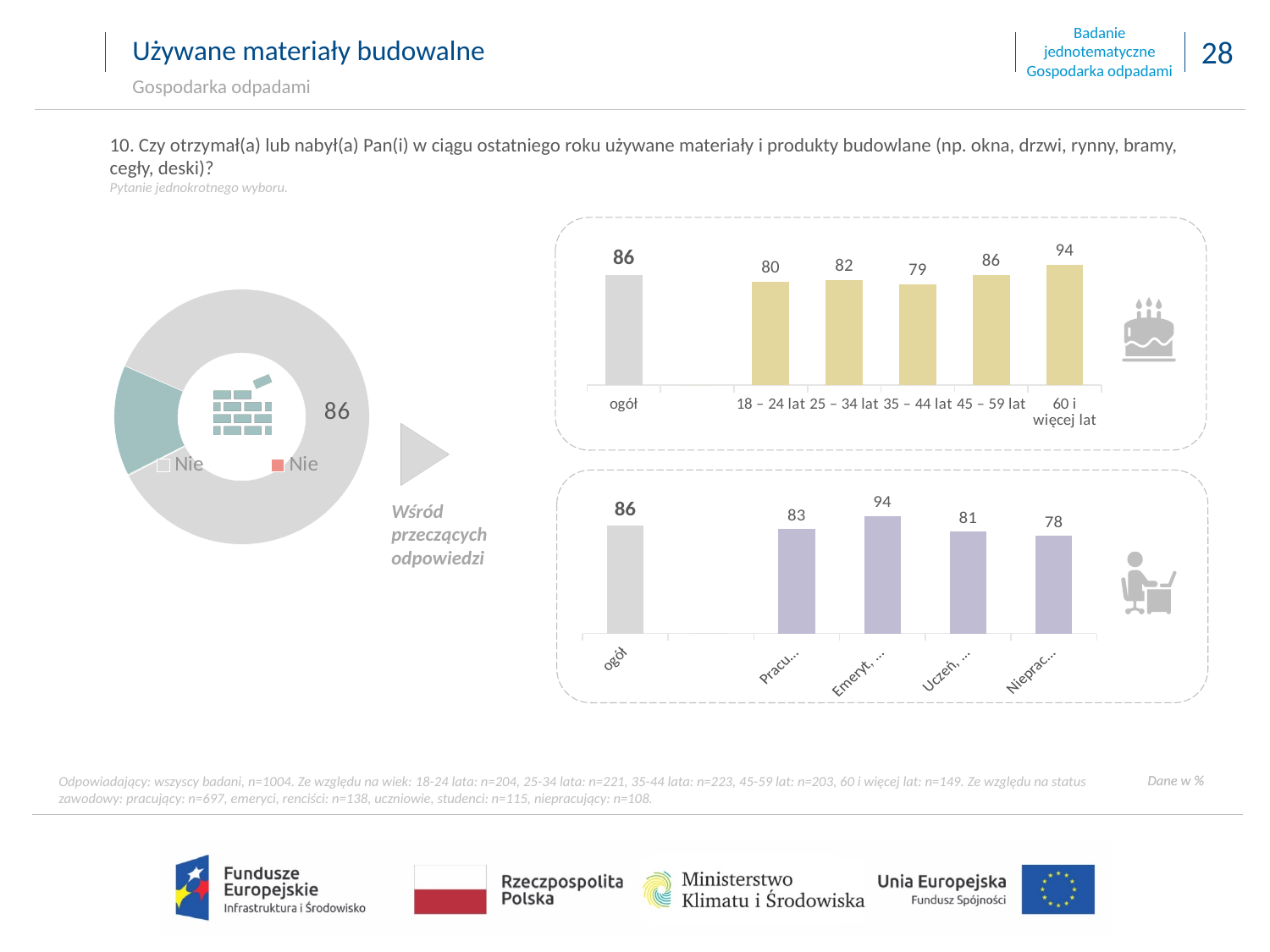
What type of chart is shown in the top right panel by age? Bar chart In the top right bar chart by age, what is the value for 60 i więcej lat? 94 In the bottom right bar chart by occupational status, what is the value for ogół? 86 In the top right bar chart by age, what is the value for 35 – 44 lat? 79 In the top right bar chart by age, how many bars are plotted? 6 What value is printed inside the donut chart on the left? 86 In the bottom right bar chart by occupational status, what is the value of the bar labelled 'Nieprac...'? 78 In the bottom right bar chart by occupational status, what is the value of the bar labelled 'Emeryt...'? 94 In the bottom right bar chart by occupational status, which bar is larger: 'Pracu...' or 'Uczeń...'? Pracu... In the top right bar chart by age, which age group has the lowest value? 35 – 44 lat In the top right bar chart by age, what is the difference between the values for 60 i więcej lat and 18 – 24 lat? 14 In the top right bar chart by age, which age group has the highest value? 60 i więcej lat